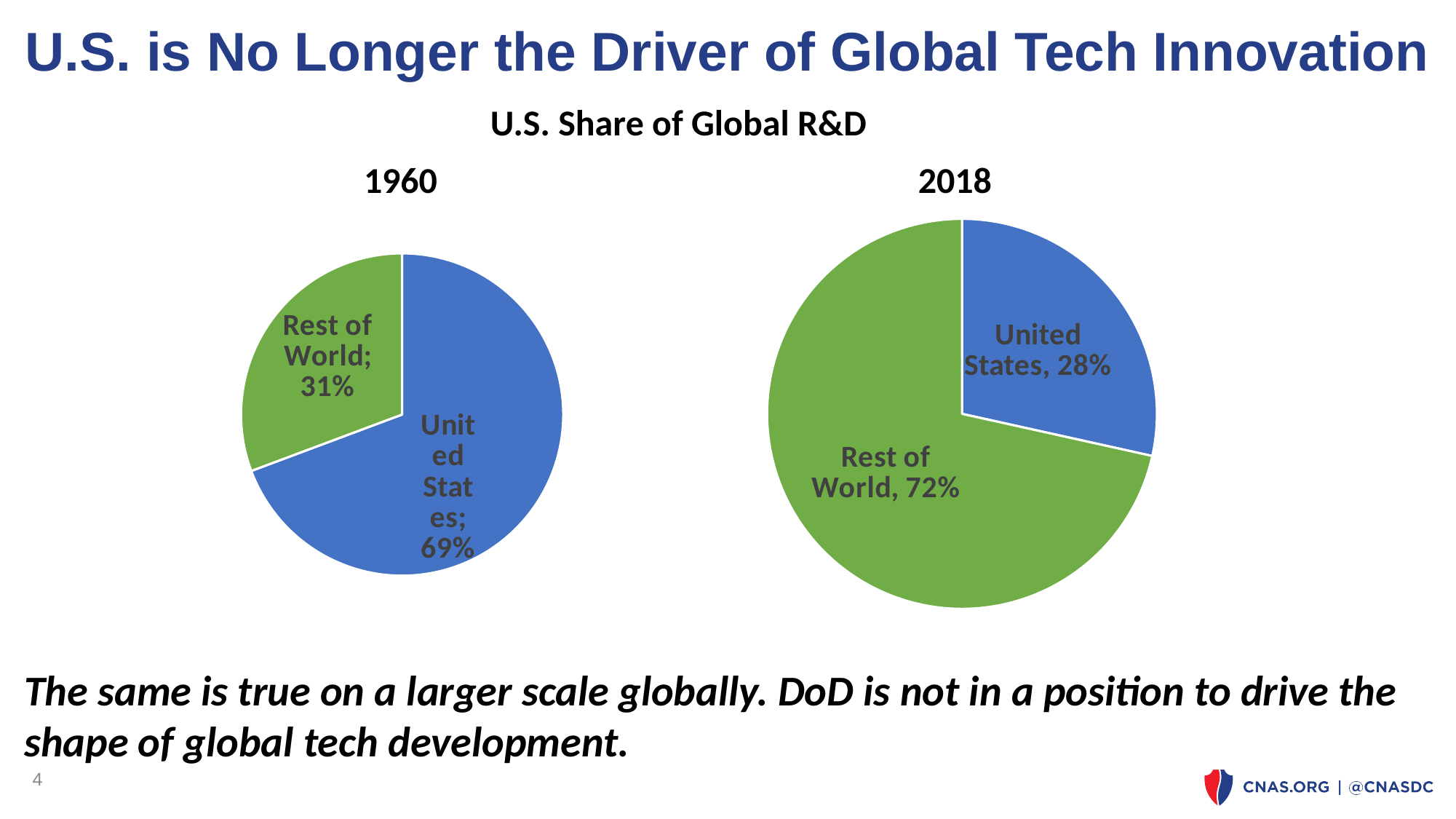
What type of chart is used for the 1960 and 2018 data? Pie chart In the 1960 pie chart, what is the difference between the United States and Rest of World shares? 38 percentage points In the 2018 pie chart, which slice is the smallest? United States In the 2018 pie chart, what share does the United States have? 28% In the 1960 pie chart, what share does Rest of World have? 31% In the 2018 pie chart, what share does Rest of World have? 72% In the 1960 pie chart, what share does the United States have? 69% How many slices does the 2018 pie chart have? 2 What is the title shown above the two pie charts? U.S. Share of Global R&D In the 1960 pie chart, which slice is the largest? United States What is the difference between the United States share in 1960 and in 2018? 41 percentage points In the 2018 pie chart, which is larger, United States or Rest of World? Rest of World